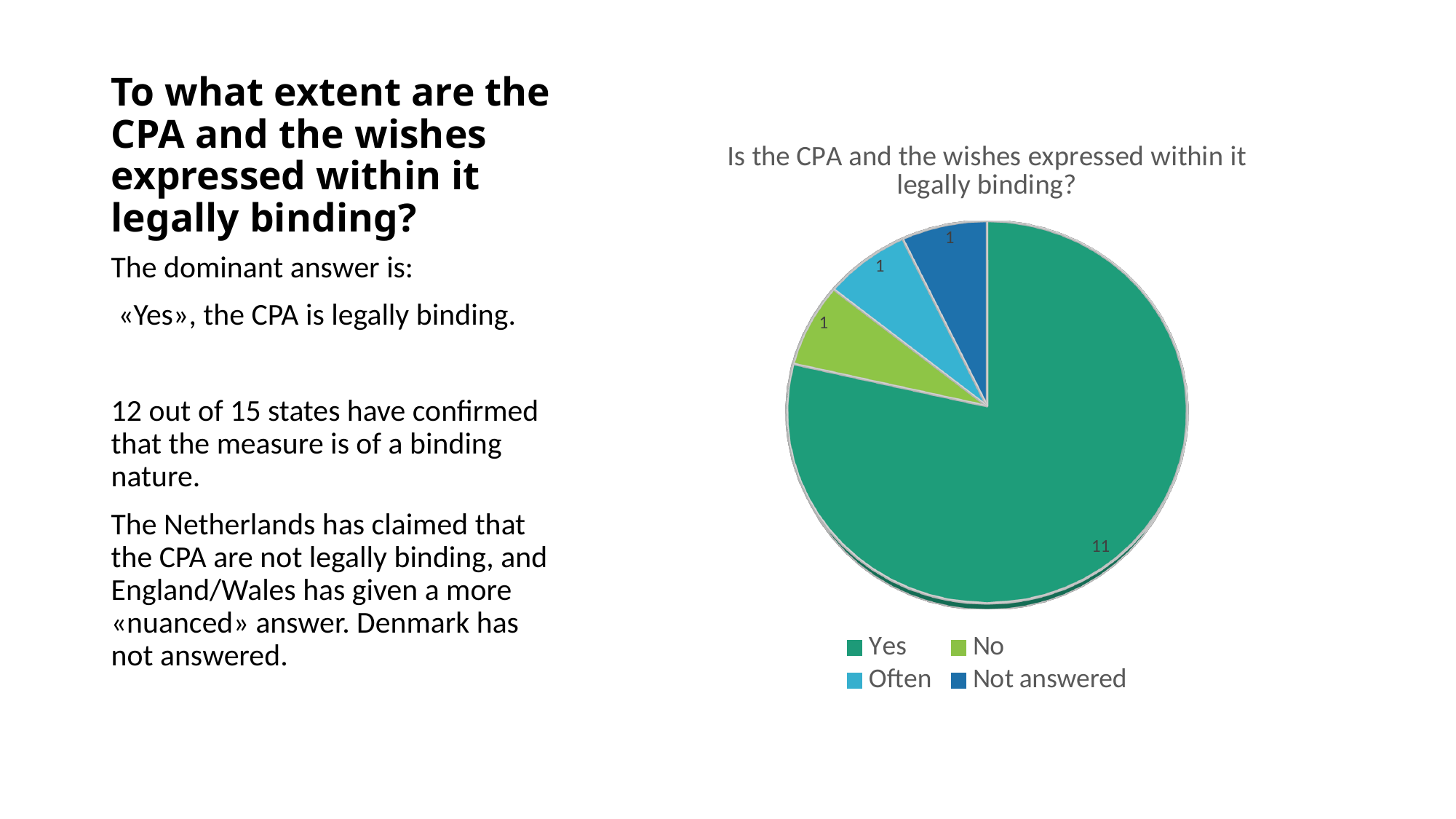
What kind of chart is shown on the slide? pie chart What is the value for the "Often" slice in the pie chart? 1 What is the value for the "Yes" slice in the pie chart? 11 Which category has the largest slice in the pie chart? Yes What is the value for the "No" slice in the pie chart? 1 What is the difference between the "Yes" value and the "No" value in the pie chart? 10 Which is larger in the pie chart, the "Yes" slice or the "Often" slice? Yes What is the title of the pie chart? Is the CPA and the wishes expressed within it legally binding? What is the total of all the values shown in the pie chart? 14 How many slices does the pie chart have? 4 What is the value for the "Not answered" slice in the pie chart? 1 How many entries does the legend of the pie chart list? 4